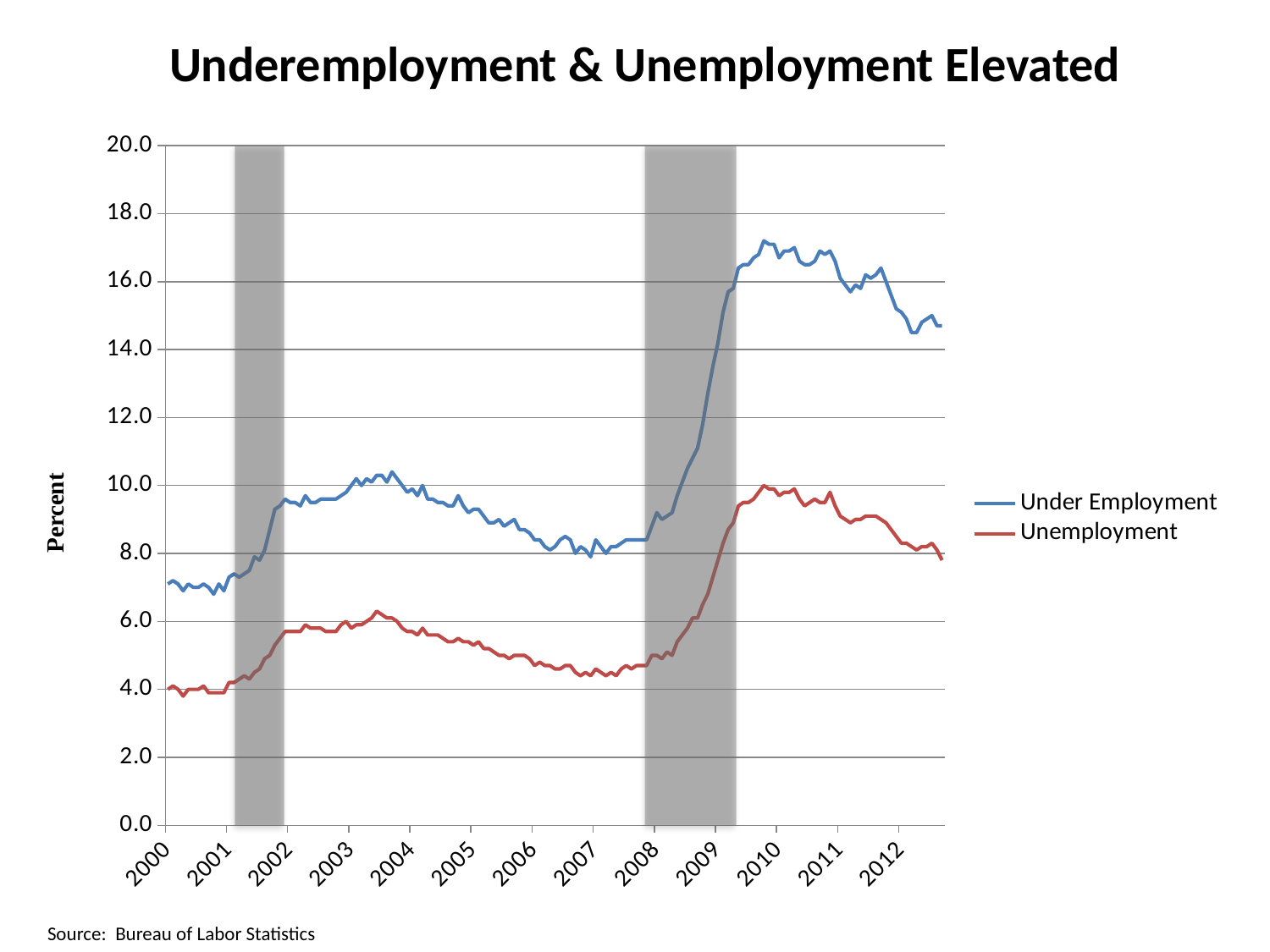
What is the label on the vertical axis? Percent Is the value for Unemployment at the start of 2010 greater or less than 8.0? greater Is the value for Under Employment at the start of 2000 greater or less than 8.0? less Is the value for Under Employment at the start of 2010 greater or less than 16.0? greater What is the title of the chart? Underemployment & Unemployment Elevated What kind of chart is shown on the slide? line chart Does the Under Employment line rise or fall between 2010 and 2012? fall Does the Unemployment line rise or fall between 2008 and 2009? rise Which series has the higher value in 2010, Under Employment or Unemployment? Under Employment How many series does the legend list? 2